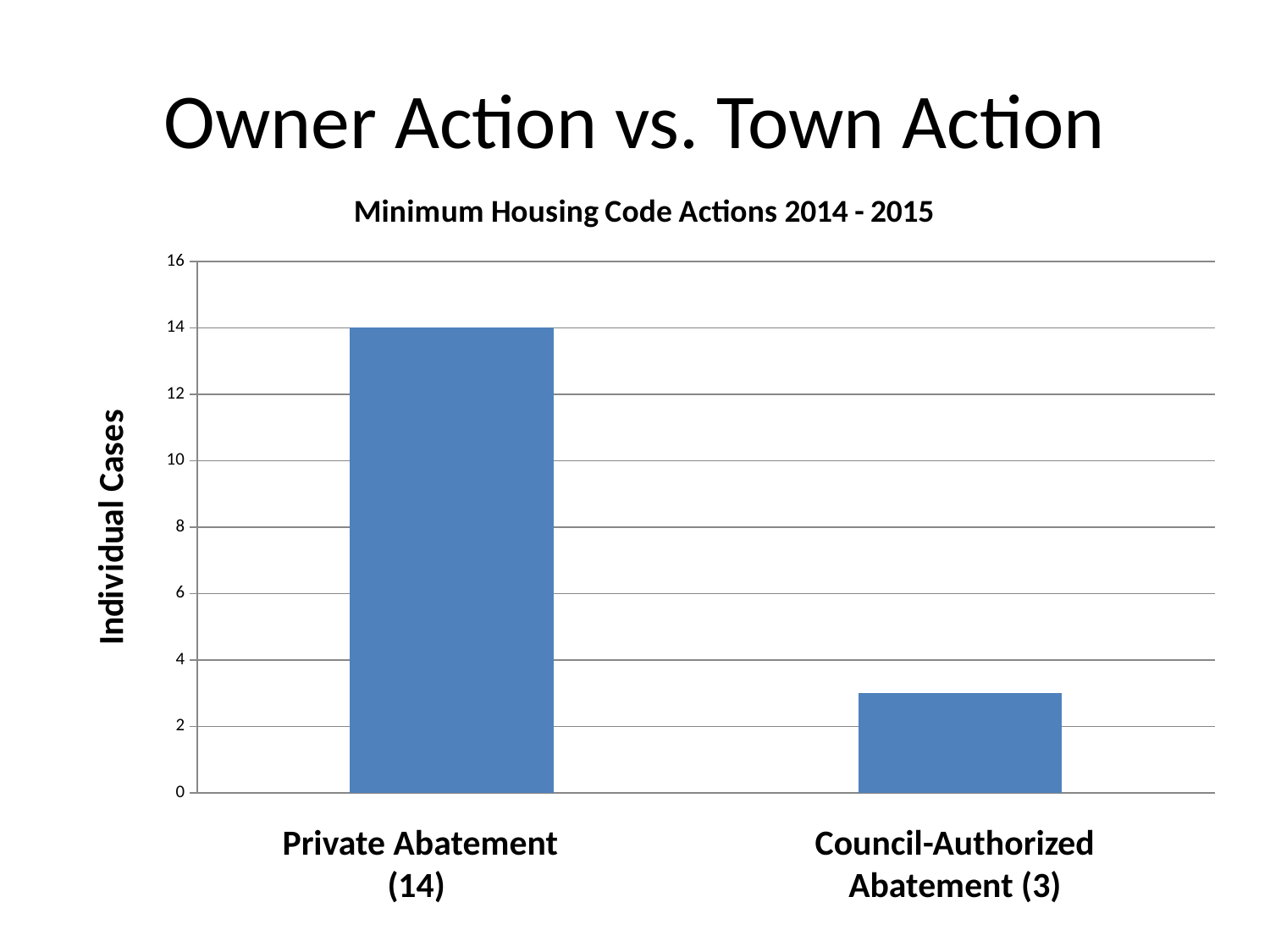
What type of chart is shown on the slide? bar chart Which category has the higher number of individual cases? Private Abatement How many categories are plotted in the chart? 2 How many cases are shown for Council-Authorized Abatement? 3 What is the label of the vertical axis? Individual Cases Which is larger: the value for Council-Authorized Abatement or the value for Private Abatement? Private Abatement How many cases are shown for Private Abatement? 14 What is the title of the chart? Minimum Housing Code Actions 2014 - 2015 Is the value for Council-Authorized Abatement greater or less than 4? less Which category has the lower number of individual cases? Council-Authorized Abatement Is the value for Private Abatement greater or less than 10? greater What is the difference in cases between Private Abatement and Council-Authorized Abatement? 11